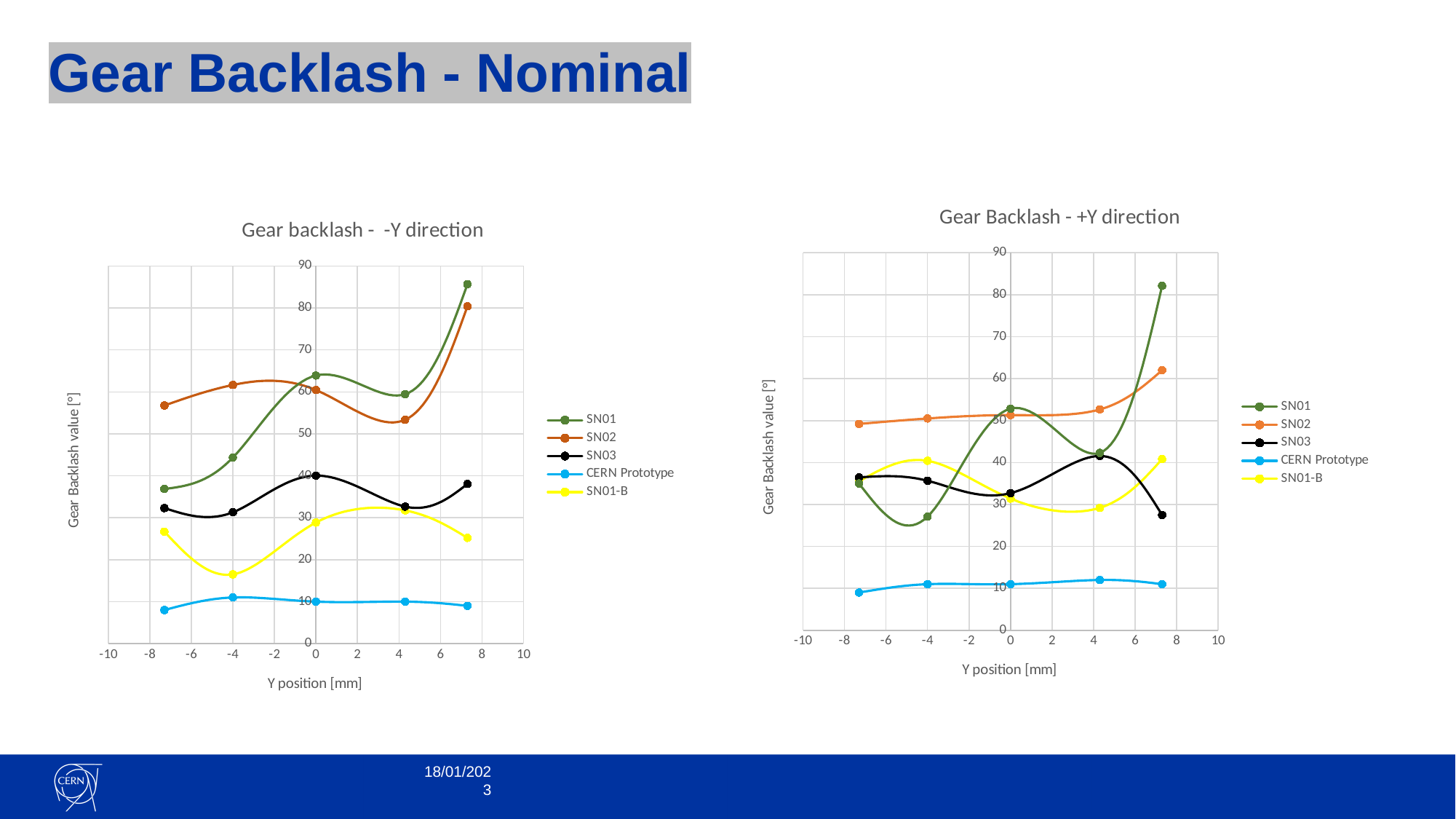
In the 'Gear backlash - -Y direction' chart, which series has the highest value at the rightmost Y position (about 7 mm)? SN01 In the 'Gear Backlash - +Y direction' chart, is the SN03 value at the rightmost Y position (about 7 mm) greater or less than 40? less In the 'Gear backlash - -Y direction' chart, is the SN01 value at the rightmost Y position (about 7 mm) greater or less than 80? greater How many series does the legend of the 'Gear Backlash - +Y direction' chart list? 5 In the 'Gear backlash - -Y direction' chart, are the CERN Prototype values greater or less than 20? less What kind of chart is the 'Gear backlash - -Y direction' chart? line chart In the 'Gear Backlash - +Y direction' chart, at Y position 0 mm, which is larger: SN02 or SN03? SN02 In the 'Gear backlash - -Y direction' chart, which series has the lowest values across all Y positions? CERN Prototype In the 'Gear Backlash - +Y direction' chart, does the SN02 series rise or fall as the Y position increases from left to right? rise In the 'Gear Backlash - +Y direction' chart, which series has the lowest values across all Y positions? CERN Prototype What is the y-axis label of the 'Gear backlash - -Y direction' chart? Gear Backlash value [°]